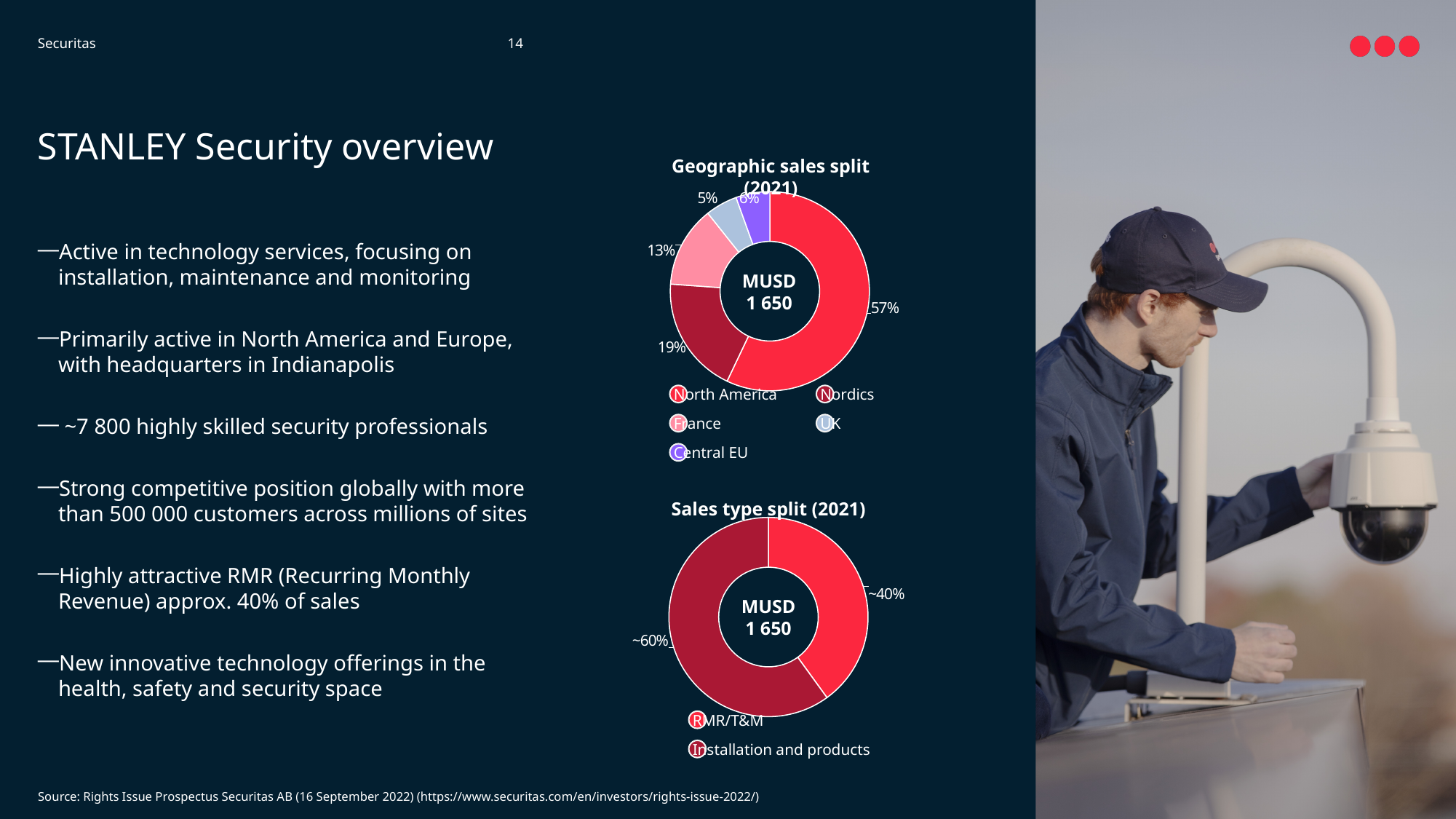
In the Geographic sales split (2021) chart, what share of sales comes from the Nordics? 19% How many categories does the Sales type split (2021) chart show? 2 In the Geographic sales split (2021) chart, how many percentage points larger is North America's share than the Nordics' share? 38 percentage points In the Sales type split (2021) chart, which is larger: RMR/T&M or Installation and products? Installation and products In the Geographic sales split (2021) chart, what share of sales comes from North America? 57% In the Geographic sales split (2021) chart, is the share for Central EU greater or less than the share for UK? greater What total value is shown in the centre of the Geographic sales split (2021) chart? MUSD 1 650 In the Geographic sales split (2021) chart, what share of sales comes from France? 13% In the Geographic sales split (2021) chart, which region has the smallest share? UK How many regions are shown in the Geographic sales split (2021) chart? 5 In the Geographic sales split (2021) chart, which region has the largest share? North America What kind of chart is the Geographic sales split (2021) chart? Pie (donut) chart